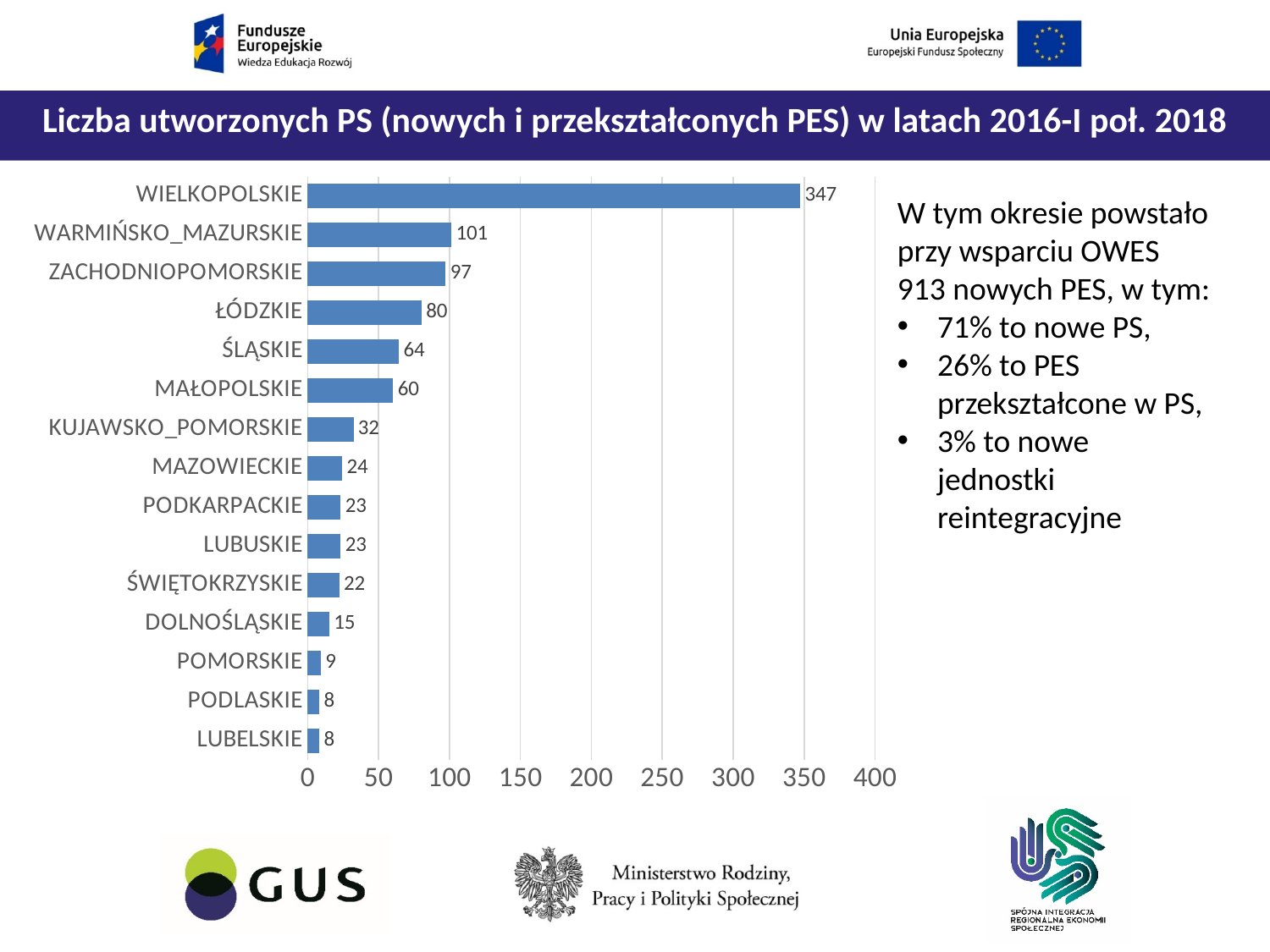
Which is larger, the value for ZACHODNIOPOMORSKIE or the value for ŁÓDZKIE? ZACHODNIOPOMORSKIE What is the title of the chart on the slide? Liczba utworzonych PS (nowych i przekształconych PES) w latach 2016-I poł. 2018 What is the value for KUJAWSKO_POMORSKIE? 32 Which category has the highest value? WIELKOPOLSKIE What kind of chart is shown on the slide? bar chart How many categories are shown in the chart? 15 What is the difference between the values for WIELKOPOLSKIE and WARMIŃSKO_MAZURSKIE? 246 What is the difference between the values for ŚLĄSKIE and MAŁOPOLSKIE? 4 Is the value for WARMIŃSKO_MAZURSKIE greater or less than 100? greater What is the value for DOLNOŚLĄSKIE? 15 What is the value for WIELKOPOLSKIE? 347 What is the value for ŁÓDZKIE? 80